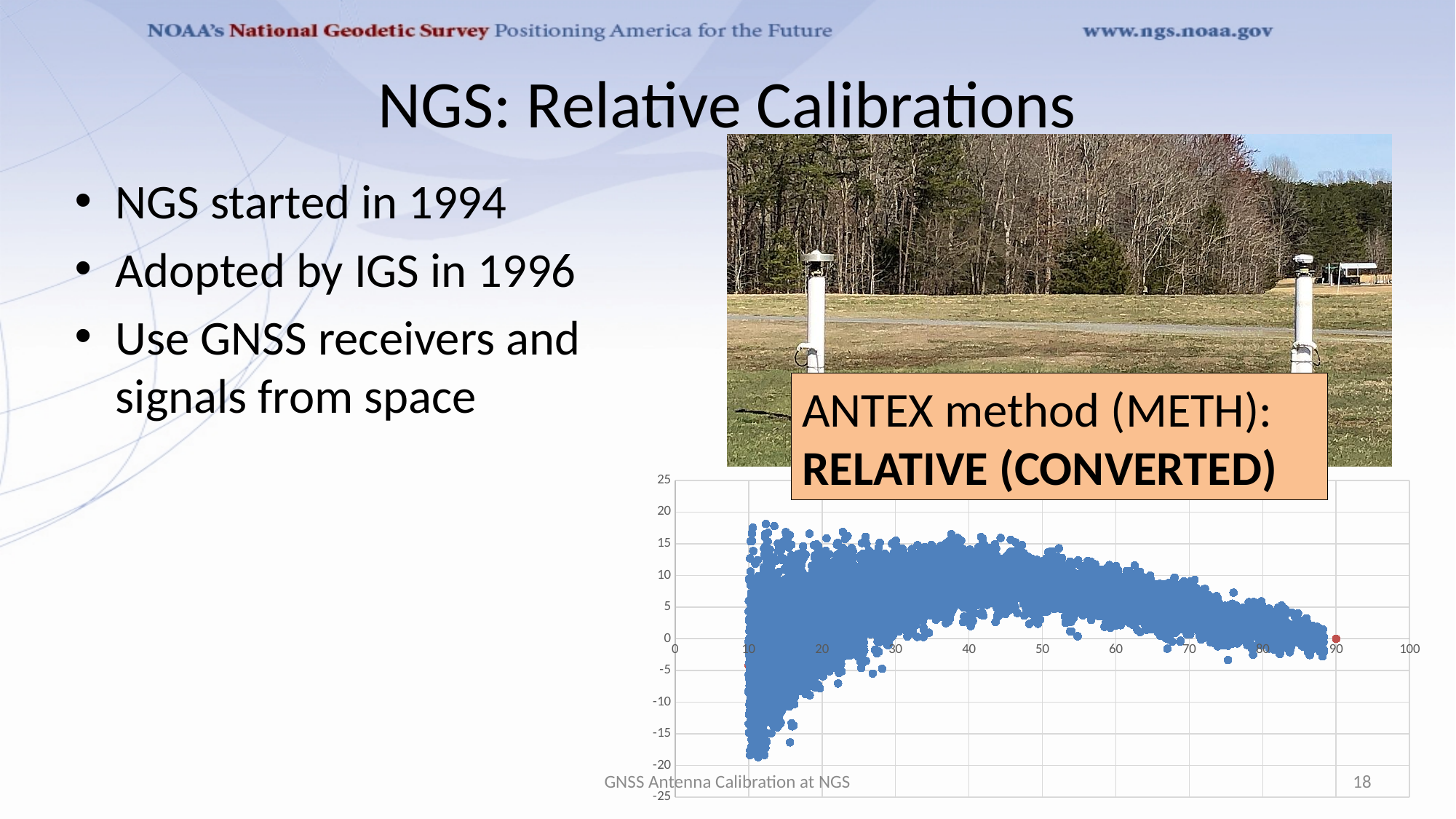
What kind of chart is shown at the bottom right of the slide? scatter chart What is the highest value labelled on the y axis of the scatter chart? 25 In the scatter chart, are the plotted values near x = 40 greater or less than -5? greater In the scatter chart, do the plotted values generally rise or fall as x increases from 50 to 90? fall In the scatter chart, are the highest plotted values near x = 10 greater or less than 15? greater In the scatter chart, are the lowest plotted values near x = 10 greater or less than -15? less What is the highest value labelled on the x axis of the scatter chart? 100